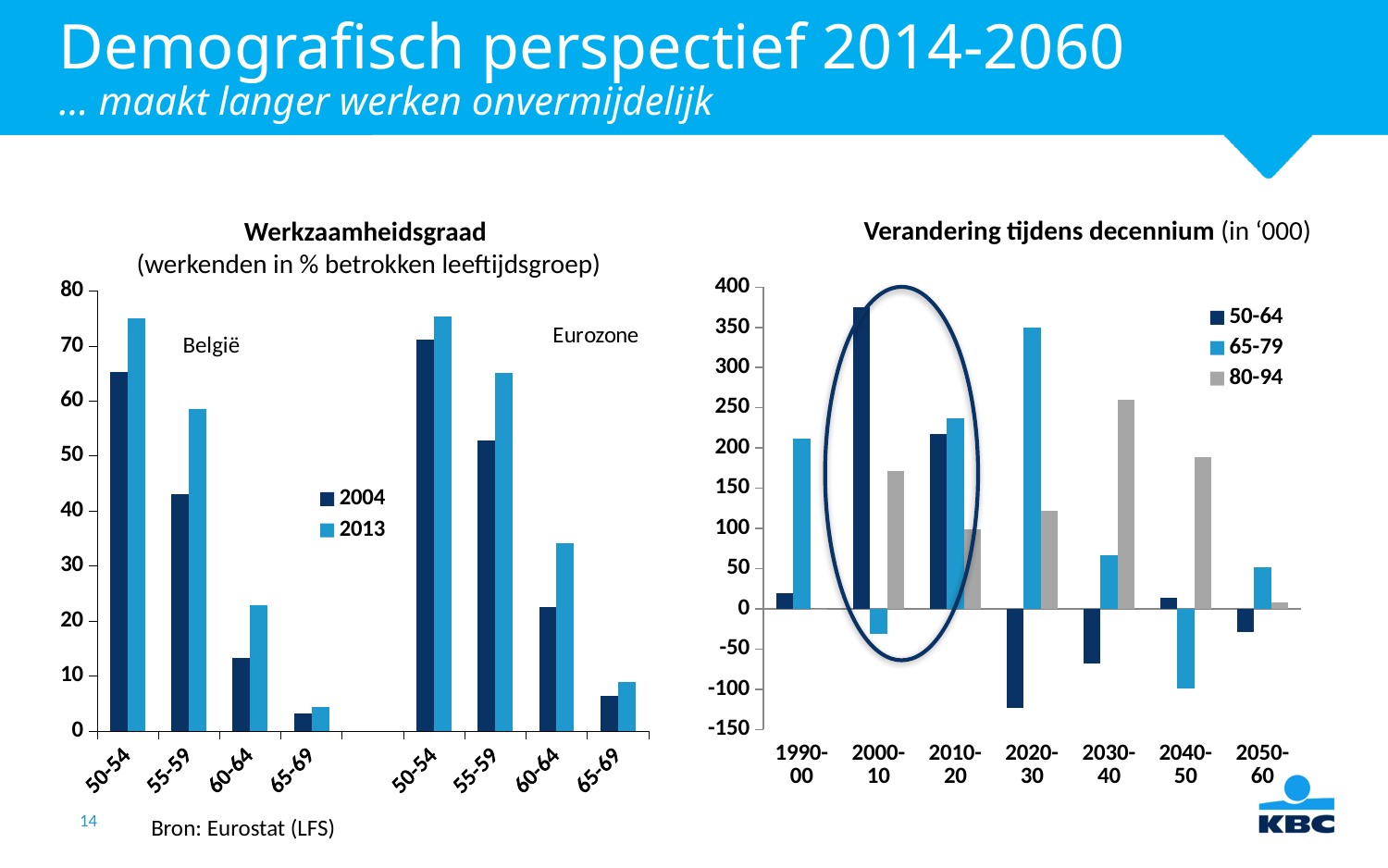
In the 'Verandering tijdens decennium' chart, in which decade is the 50-64 series highest? 2000-10 In the 'Werkzaamheidsgraad' chart, which is larger for the 55-59 group in 2013: België or Eurozone? Eurozone In the 'Verandering tijdens decennium' chart, in which decade is the 50-64 series lowest? 2020-30 In the 'Werkzaamheidsgraad' chart, is the 2013 value for Eurozone 60-64 greater or less than 30? greater In the 'Verandering tijdens decennium' chart, is the 65-79 value for 2040-50 greater or less than -50? less In the 'Werkzaamheidsgraad' chart, which bar is the lowest of all? België 65-69, 2004 In the 'Werkzaamheidsgraad' chart, how many age groups are shown for België? 4 How many series does the legend of the 'Verandering tijdens decennium' chart list? 3 What kind of chart is the 'Werkzaamheidsgraad' chart on the left? bar chart In the 'Werkzaamheidsgraad' chart, do the 2013 values for België rise or fall from 50-54 to 65-69? fall In the 'Werkzaamheidsgraad' chart, is the 2013 value for België 50-54 greater or less than 70? greater How many series does the legend of the 'Werkzaamheidsgraad' chart list? 2